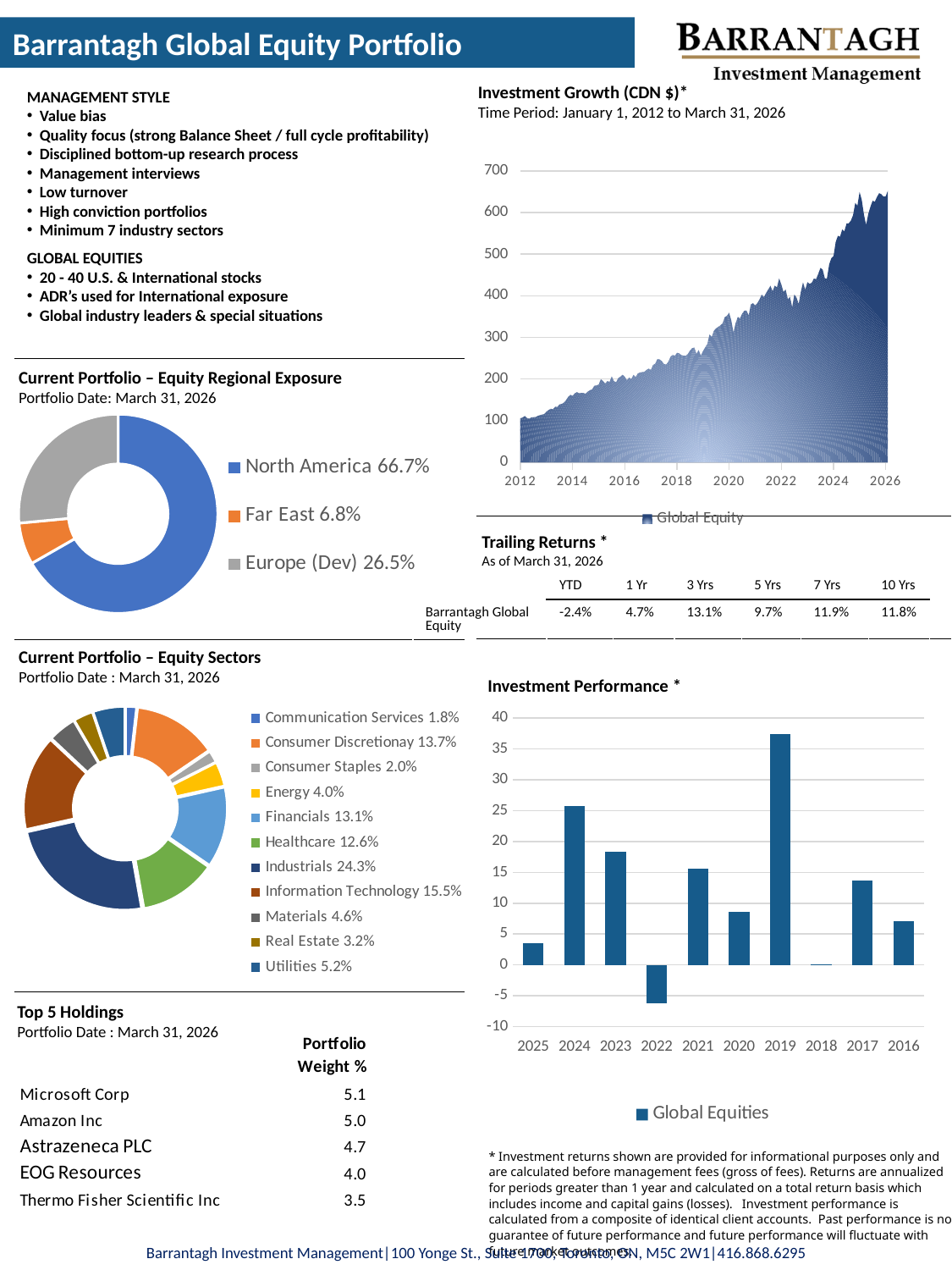
In the Current Portfolio – Equity Regional Exposure chart, what share does North America represent? 66.7% In the Investment Performance chart, which year has the lowest bar? 2022 In the Investment Growth (CDN $) chart, do the values generally rise or fall from 2012 to 2026? rise In the Current Portfolio – Equity Regional Exposure chart, which region has the smallest share? Far East What kind of chart is the Investment Performance chart? bar chart In the Current Portfolio – Equity Sectors chart, which is larger, Consumer Discretionay or Healthcare? Consumer Discretionay In the Current Portfolio – Equity Sectors chart, which sector has the smallest share? Communication Services In the Current Portfolio – Equity Sectors chart, what is the share for Industrials? 24.3% In the Investment Performance chart, is the value for 2019 greater or less than 35? greater In the Investment Performance chart, which year has the highest bar? 2019 In the Current Portfolio – Equity Sectors chart, what is the difference between the Information Technology and Financials shares? 2.4% In the Current Portfolio – Equity Sectors chart, how many sectors are shown? 11